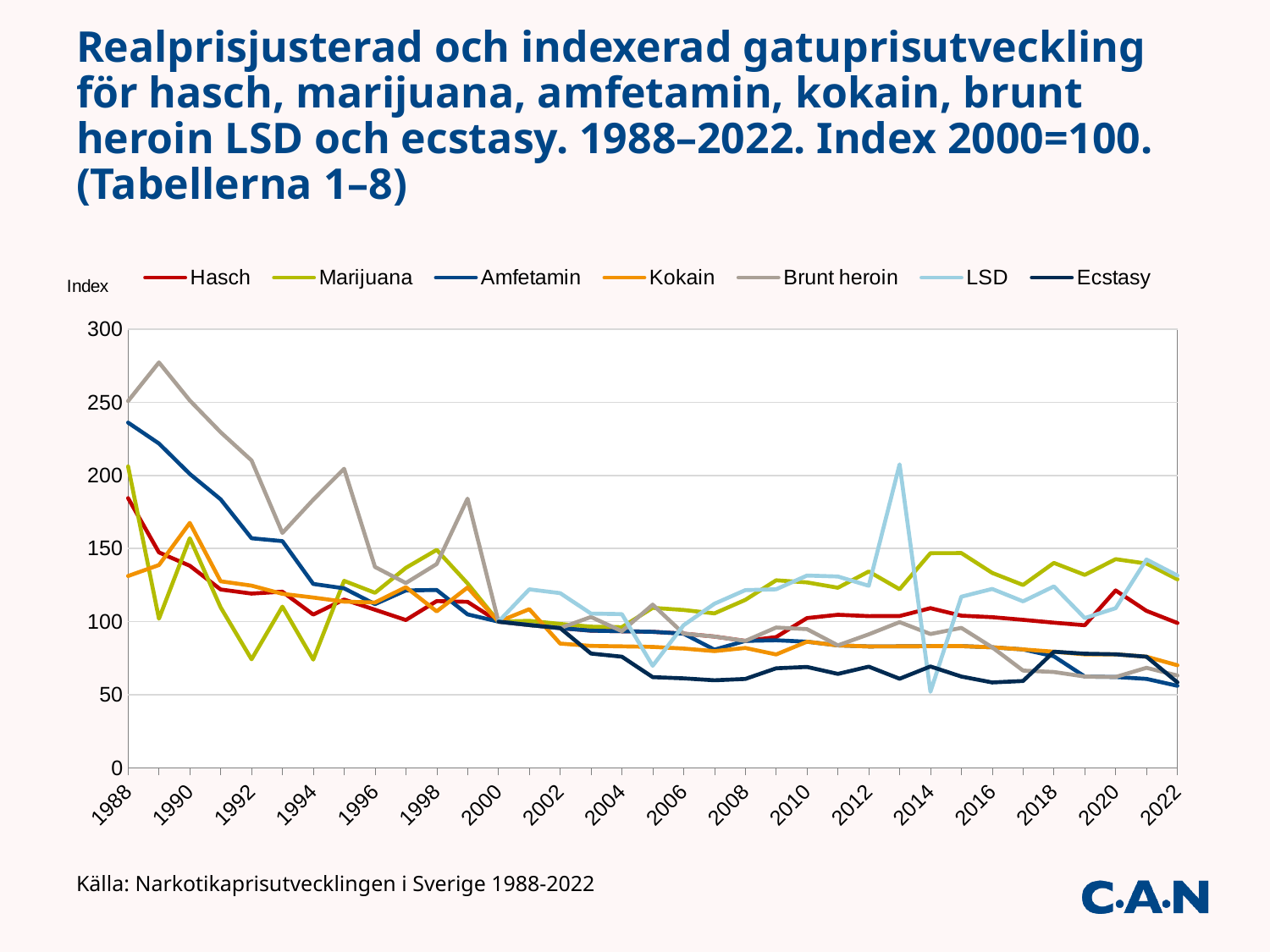
What label is shown on the vertical axis of the chart? Index Does the Amfetamin series rise or fall overall from 1988 to 2022? fall In 1988, which is larger: the value for Amfetamin or the value for Hasch? Amfetamin Is the value for Brunt heroin in 1989 greater or less than 250? greater Is the value for Amfetamin in 1988 greater or less than 200? greater How many series does the legend list? 7 Is the value for Ecstasy in 2006 greater or less than 100? less Which series has the lowest value in 2006? Ecstasy Which series has the highest value in 1989? Brunt heroin What kind of chart is shown on the slide? line chart